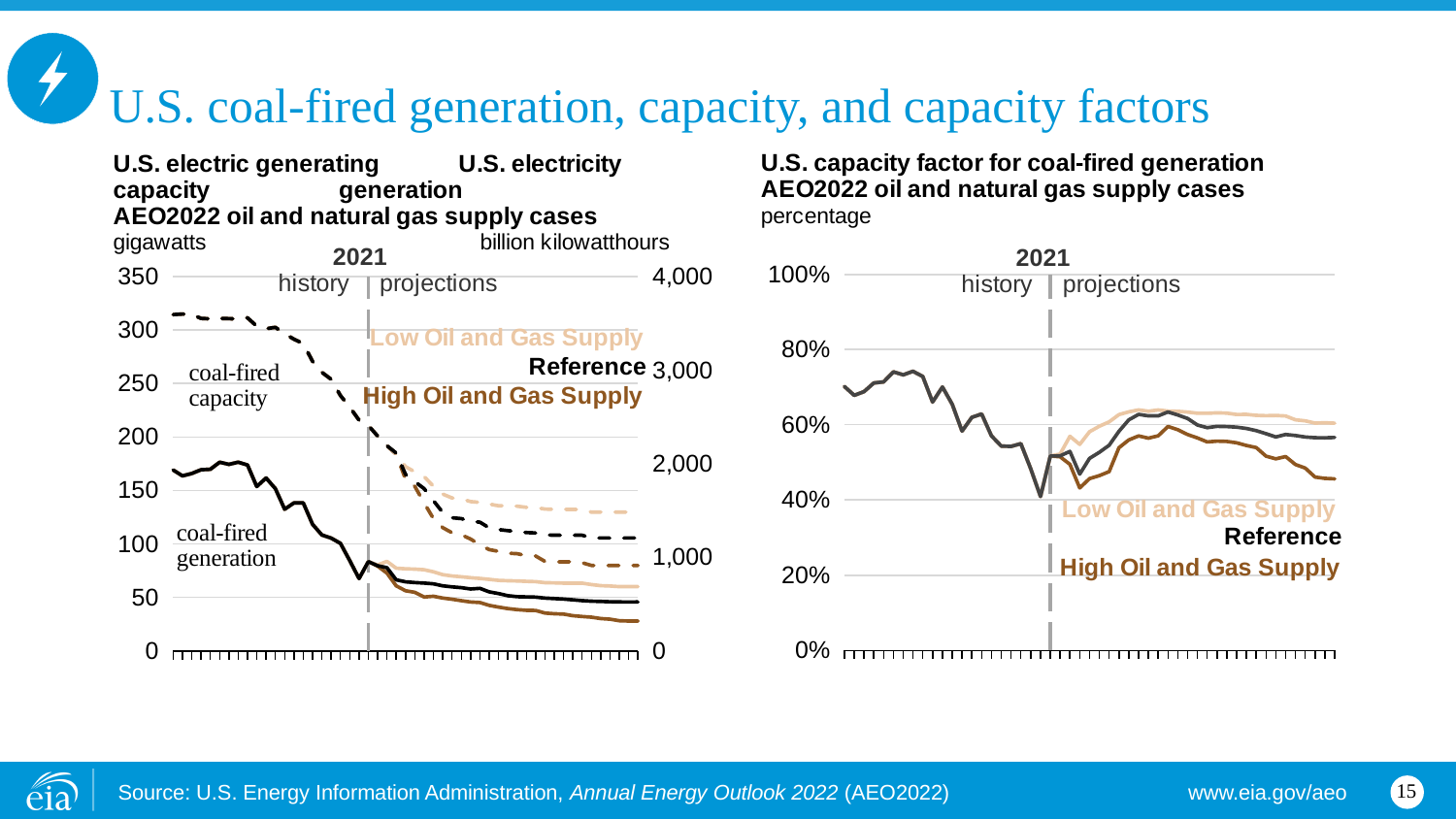
What kind of chart is the U.S. capacity factor for coal-fired generation chart on the right? line chart On the left-hand chart, is coal-fired capacity at the start of the history period greater or less than 250 gigawatts? greater On the right-hand capacity factor chart, is the value for the High Oil and Gas Supply case at the end of the projection period greater or less than 60%? less On the left-hand chart, does coal-fired capacity rise or fall over the projection period? fall On the left-hand chart, what unit is shown on the left axis for coal-fired capacity? gigawatts On the right-hand capacity factor chart, is the value for the Low Oil and Gas Supply case at the end of the projection period greater or less than 40%? greater On the left-hand chart, at the end of the projection period, which case has the higher coal-fired capacity: Low Oil and Gas Supply or High Oil and Gas Supply? Low Oil and Gas Supply On the right-hand capacity factor chart, which year separates history from projections? 2021 How many oil and natural gas supply cases are labelled on the right-hand capacity factor chart? 3 On the right-hand capacity factor chart, at the end of the projection period, which case has the higher capacity factor: Low Oil and Gas Supply or High Oil and Gas Supply? Low Oil and Gas Supply